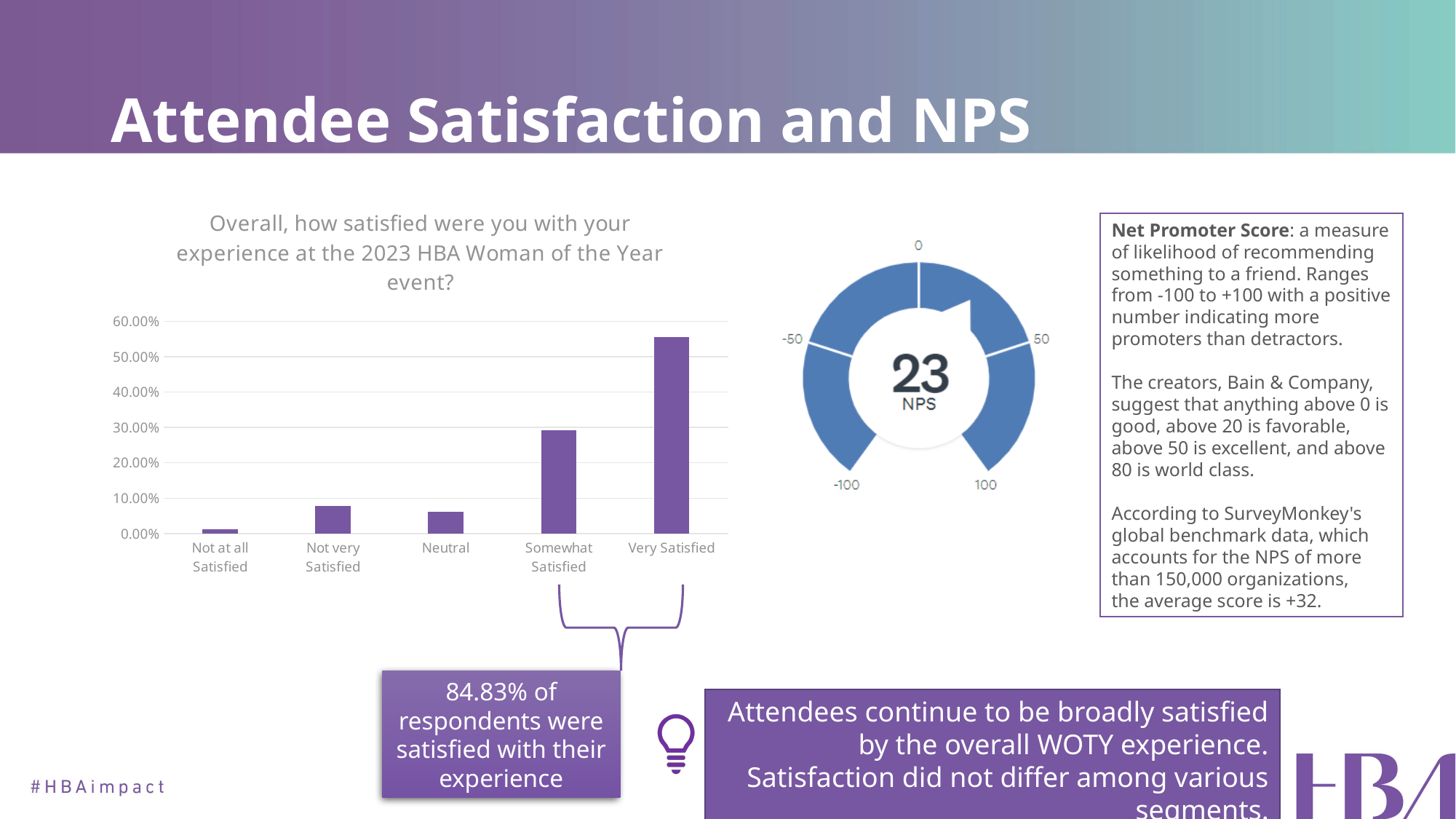
In the satisfaction bar chart, how many response categories are shown on the x axis? 5 What type of chart is used to show the answers to 'Overall, how satisfied were you with your experience at the 2023 HBA Woman of the Year event?' bar chart In the satisfaction bar chart, is the value for Not very Satisfied greater or less than 10.00%? less In the satisfaction bar chart, is the value for Neutral greater or less than 10.00%? less In the satisfaction bar chart, which is larger: the value for Somewhat Satisfied or the value for Very Satisfied? Very Satisfied What NPS value is shown on the gauge chart? 23 In the satisfaction bar chart, which is larger: the value for Not at all Satisfied or the value for Somewhat Satisfied? Somewhat Satisfied In the satisfaction bar chart, is the value for Somewhat Satisfied greater or less than 20.00%? greater What is the highest value marked on the NPS gauge chart's scale? 100 In the satisfaction bar chart, which category has the lowest value? Not at all Satisfied In the satisfaction bar chart, which category has the highest value? Very Satisfied